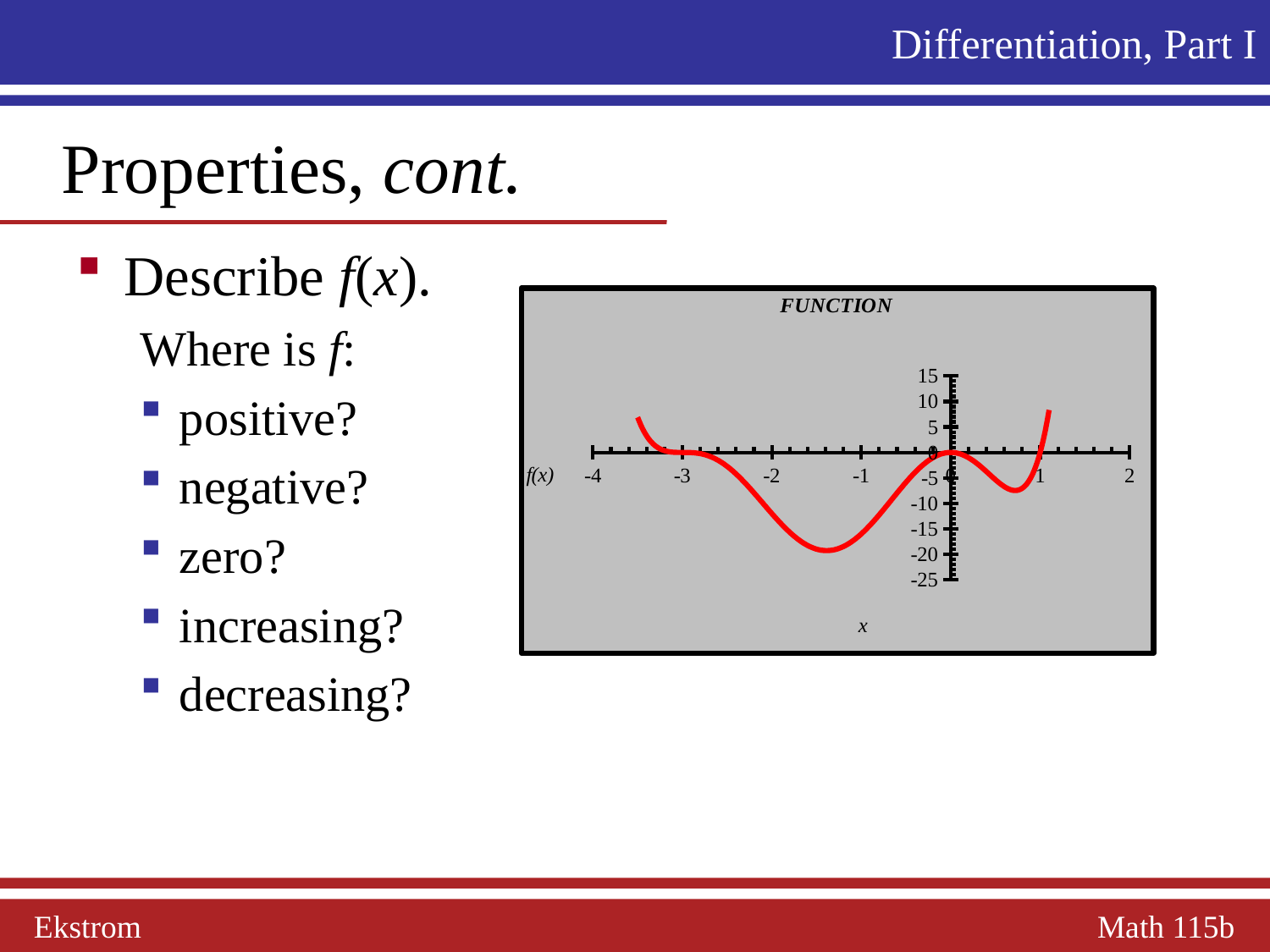
What label is shown on the horizontal axis of the chart? x Between x = -3 and x = -1.5, does the curve rise or fall as x increases? fall Which is larger, the value of the curve at x = -1 or at x = 0? x = 0 What is the title of the chart? FUNCTION Is the value of the curve at x = -2 greater or less than -5? less What kind of chart is shown on the slide? line chart Is the value of the curve at x = -3 greater or less than 5? less What is the highest tick value shown on the vertical axis of the chart? 15 Which is larger, the value of the curve at x = -3 or at x = -2? x = -3 What is the lowest tick value shown on the vertical axis of the chart? -25 Is the value of the curve at x = -1 greater or less than -5? less How many labelled tick values are shown on the x axis of the chart? 7